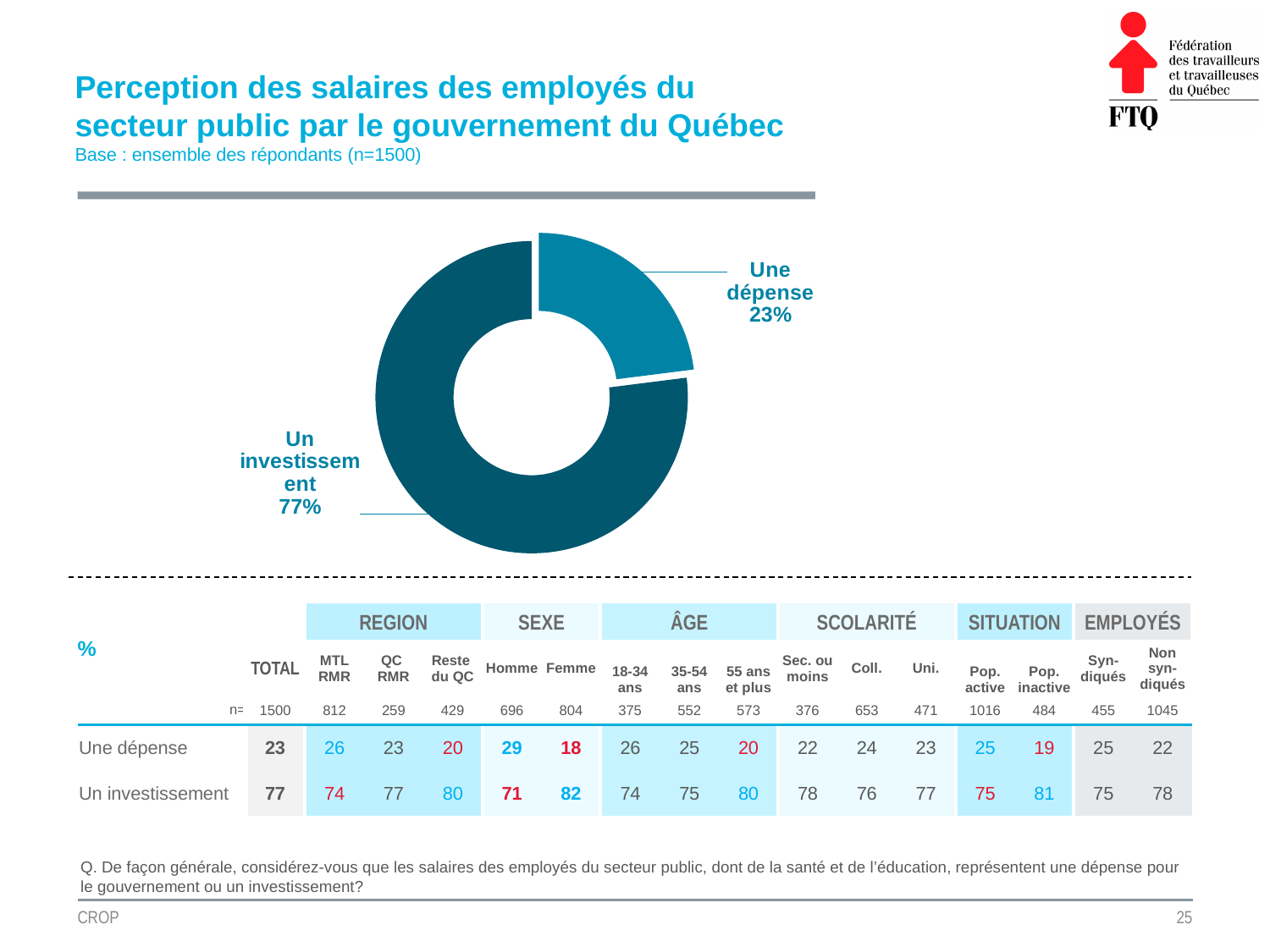
What is the combined total of the two slices in the pie chart? 100% Which is larger, the share for 'Une dépense' or the share for 'Un investissement'? Un investissement How many slices does the pie chart have? 2 What percentage of respondents consider public sector salaries 'Une dépense'? 23% What is the difference in percentage points between 'Un investissement' and 'Une dépense'? 54 Which slice of the pie chart is the smallest? Une dépense What percentage of respondents consider public sector salaries 'Un investissement'? 77% What kind of chart is shown on the slide? Doughnut chart What share of the pie does 'Un investissement' represent? 77% What is the title of the slide containing the pie chart? Perception des salaires des employés du secteur public par le gouvernement du Québec What is the base (number of respondents) stated for the chart? n=1500 Which slice of the pie chart is the largest? Un investissement